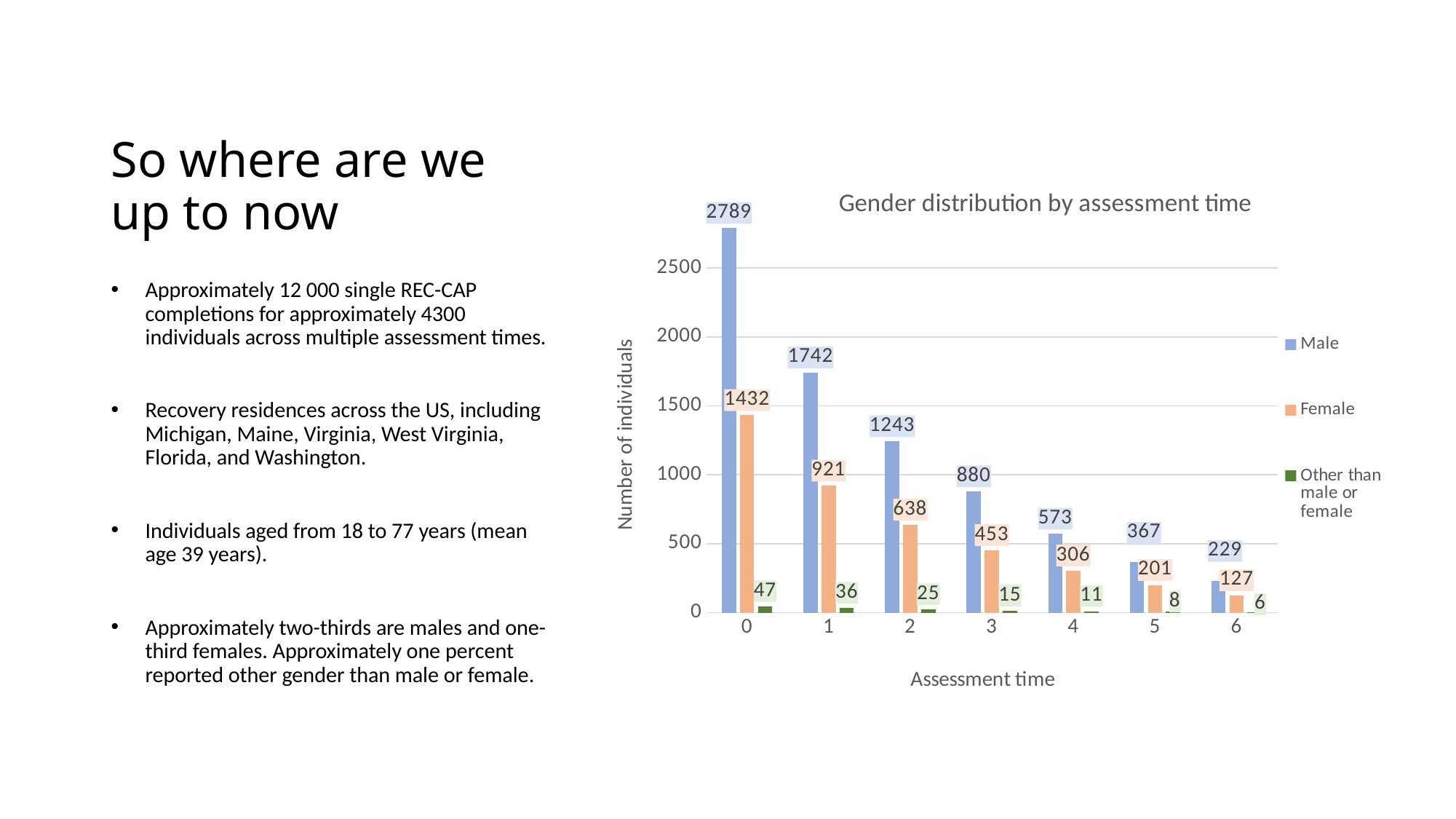
How many assessment times are shown on the x axis? 7 Do the Male values rise or fall as assessment time increases from 0 to 6? Fall What is the number of Female individuals at assessment time 3? 453 What is the value for 'Other than male or female' at assessment time 1? 36 Which is larger at assessment time 4: the Male value or the Female value? Male At which assessment time is the Female value lowest? 6 Is the Male value at assessment time 1 greater or less than 1500? greater How many series does the legend list? 3 What is the difference between the Male and Female values at assessment time 2? 605 What is the number of Male individuals at assessment time 0? 2789 What kind of chart is shown on the slide? Bar chart At which assessment time is the Male value highest? 0